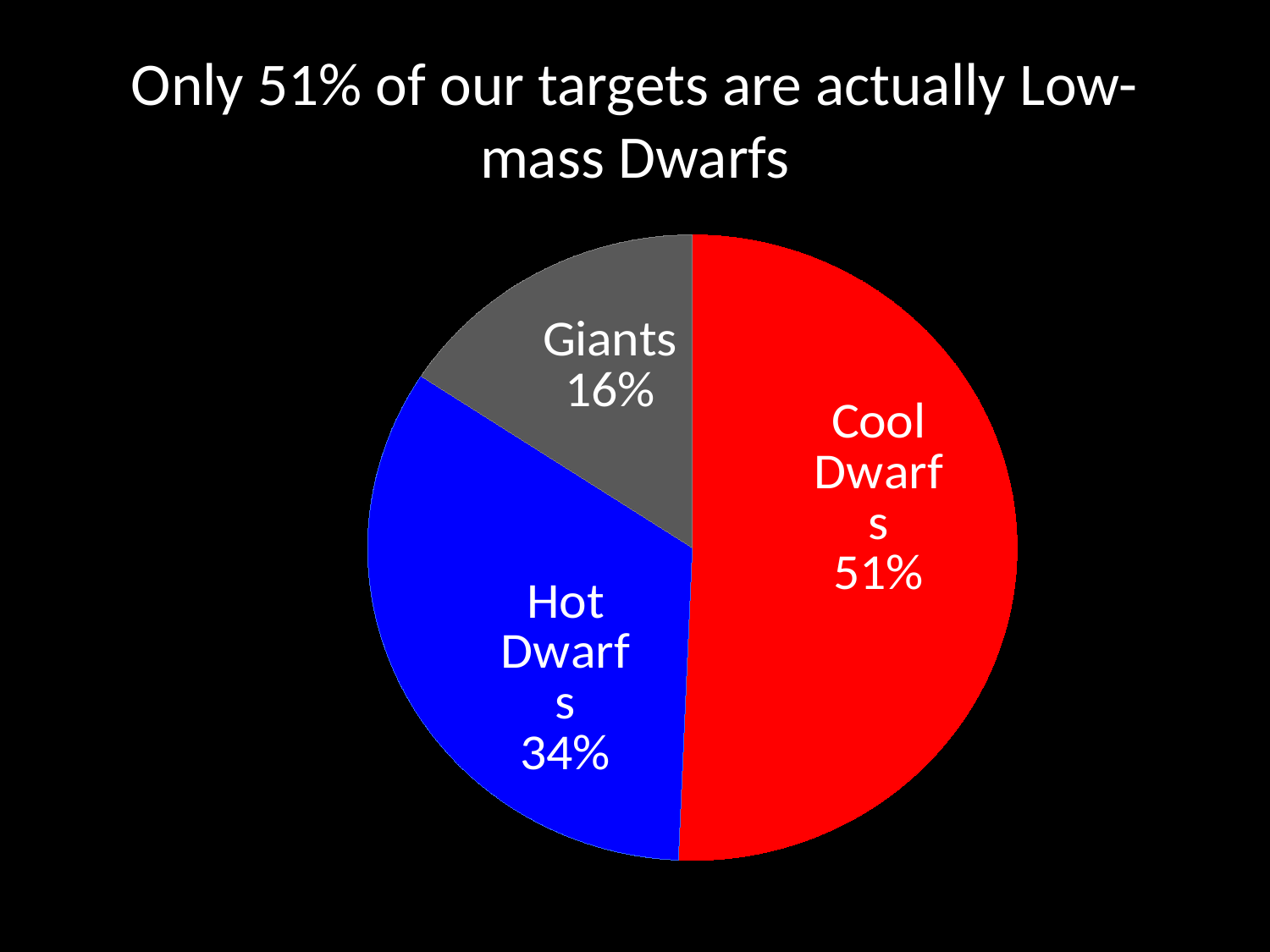
Which slice of the pie is the largest? Cool Dwarfs How many slices does the pie chart have? 3 What percentage of the pie is Cool Dwarfs? 51% What is the title of the chart? Only 51% of our targets are actually Low-mass Dwarfs What colour is the Hot Dwarfs slice? blue What is the difference in percentage points between Hot Dwarfs and Giants? 18 What is the difference in percentage points between Cool Dwarfs and Hot Dwarfs? 17 Which slice of the pie is the smallest? Giants What percentage of the pie is Hot Dwarfs? 34% What percentage of the pie is Giants? 16% What kind of chart is shown on the slide? pie chart Which is larger, the Hot Dwarfs slice or the Giants slice? Hot Dwarfs